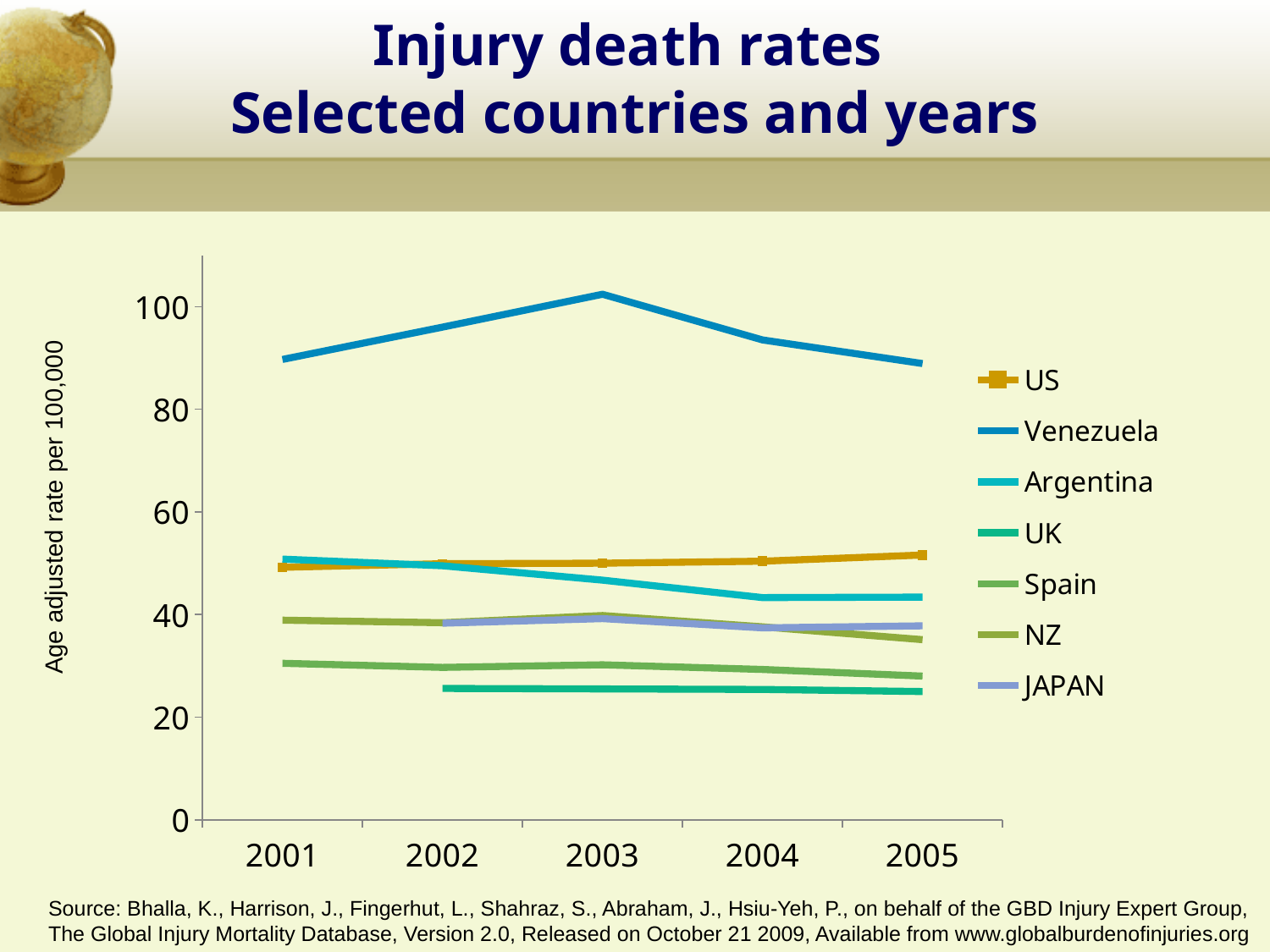
How many years are shown on the x axis? 5 Which country has the highest injury death rate in every year shown? Venezuela Which country has the lowest injury death rate in 2005? UK What kind of chart is shown on the slide? line chart Is the value for the US in 2005 greater or less than 40? greater In which year does Venezuela's injury death rate peak? 2003 How many countries does the legend list? 7 Which is larger in 2005, the value for the US or the value for Argentina? US Does Argentina's injury death rate rise or fall from 2001 to 2005? fall What is the label on the y axis? Age adjusted rate per 100,000 Is the value for Venezuela in 2001 greater or less than 80? greater Is the value for the UK in 2004 greater or less than 40? less